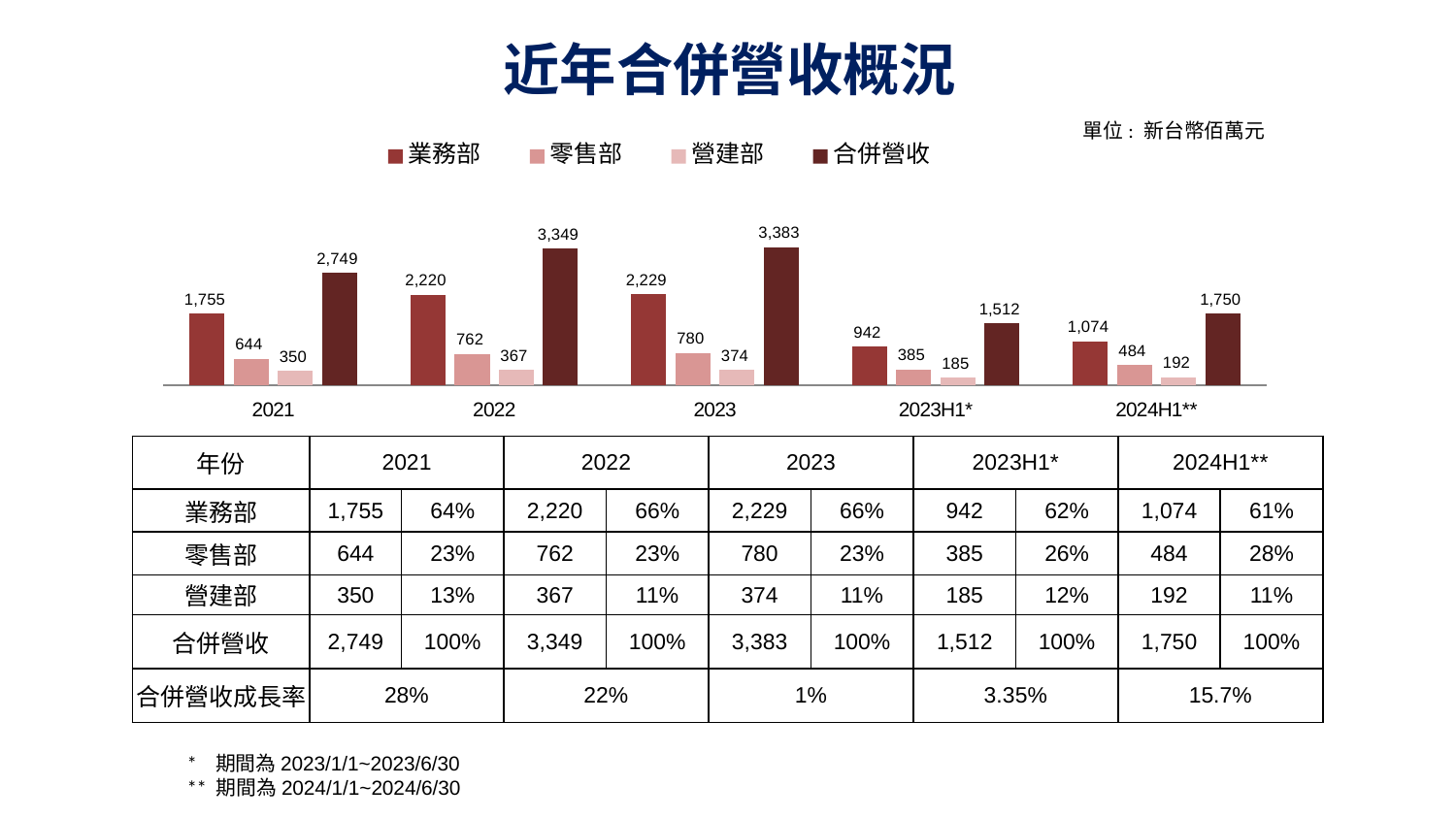
What is the value for 合併營收 in 2023? 3,383 What is the value for 業務部 in 2022? 2,220 What is the difference between the 合併營收 values for 2022 and 2021? 600 What is the value for 營建部 in 2024H1**? 192 What is the title of the chart? 近年合併營收概況 Do the 營建部 values rise or fall from 2021 to 2023? rise Which category has the highest 合併營收 value? 2023 How many categories are shown on the x axis? 5 How many series does the legend list? 4 Which category has the lowest 零售部 value? 2023H1* What kind of chart is shown on the slide? bar chart Which is larger, the 業務部 value for 2023H1* or for 2024H1**? 2024H1**